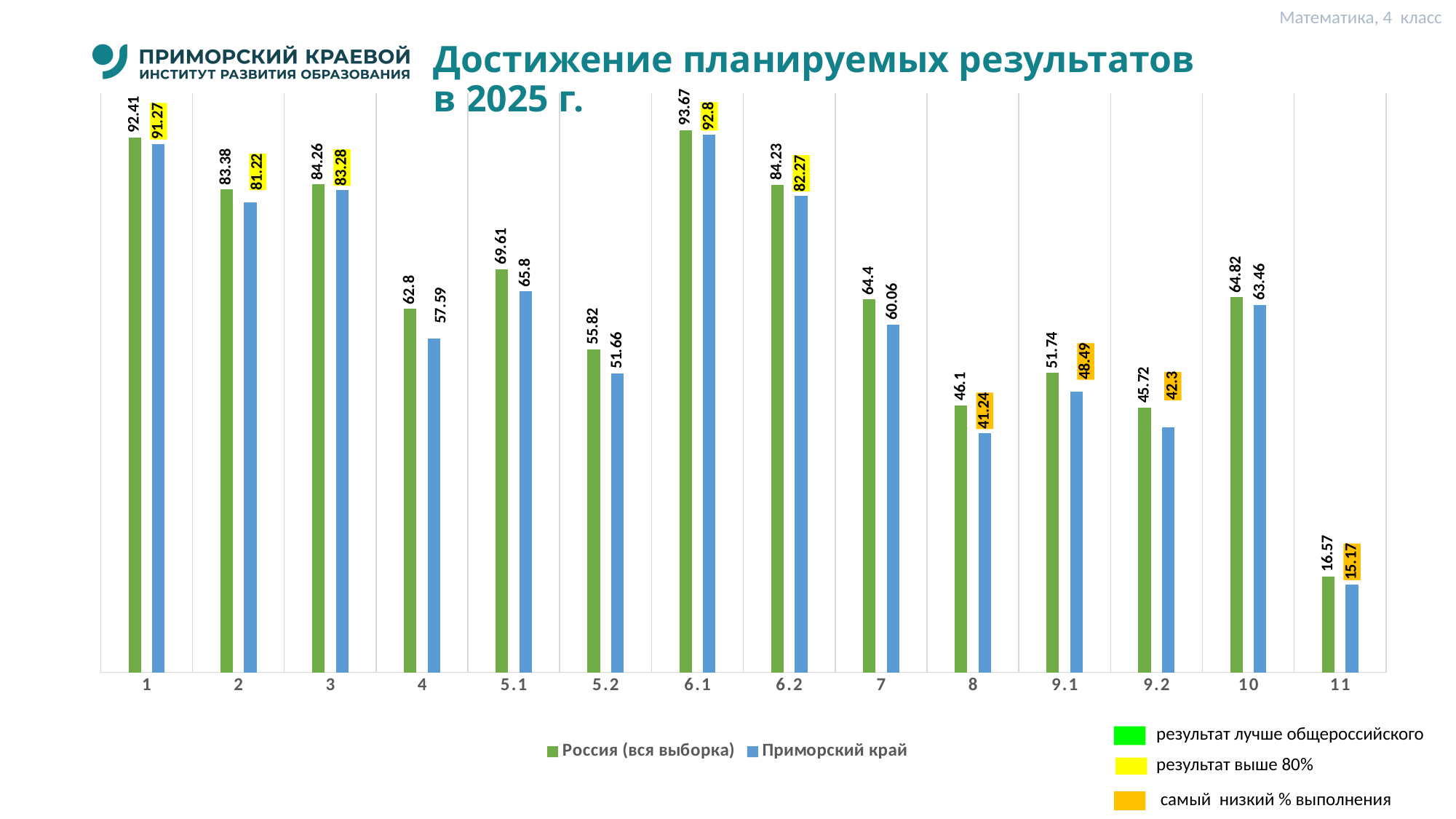
How many task categories are shown on the x axis? 14 What is the value for Приморский край for task 4? 57.59 What type of chart is shown on the slide? bar chart What is the value for Россия (вся выборка) for task 6.1? 93.67 What is the value for Приморский край for task 11? 15.17 Which task has the lowest value for Россия (вся выборка)? 11 For task 9.1, which is larger: Россия (вся выборка) or Приморский край? Россия (вся выборка) How many series does the chart legend list? 2 Which colour represents Приморский край in the chart? blue What is the difference between Россия (вся выборка) and Приморский край for task 8? 4.86 Which task has the highest value for Приморский край? 6.1 What is the difference between Россия (вся выборка) and Приморский край for task 4? 5.21